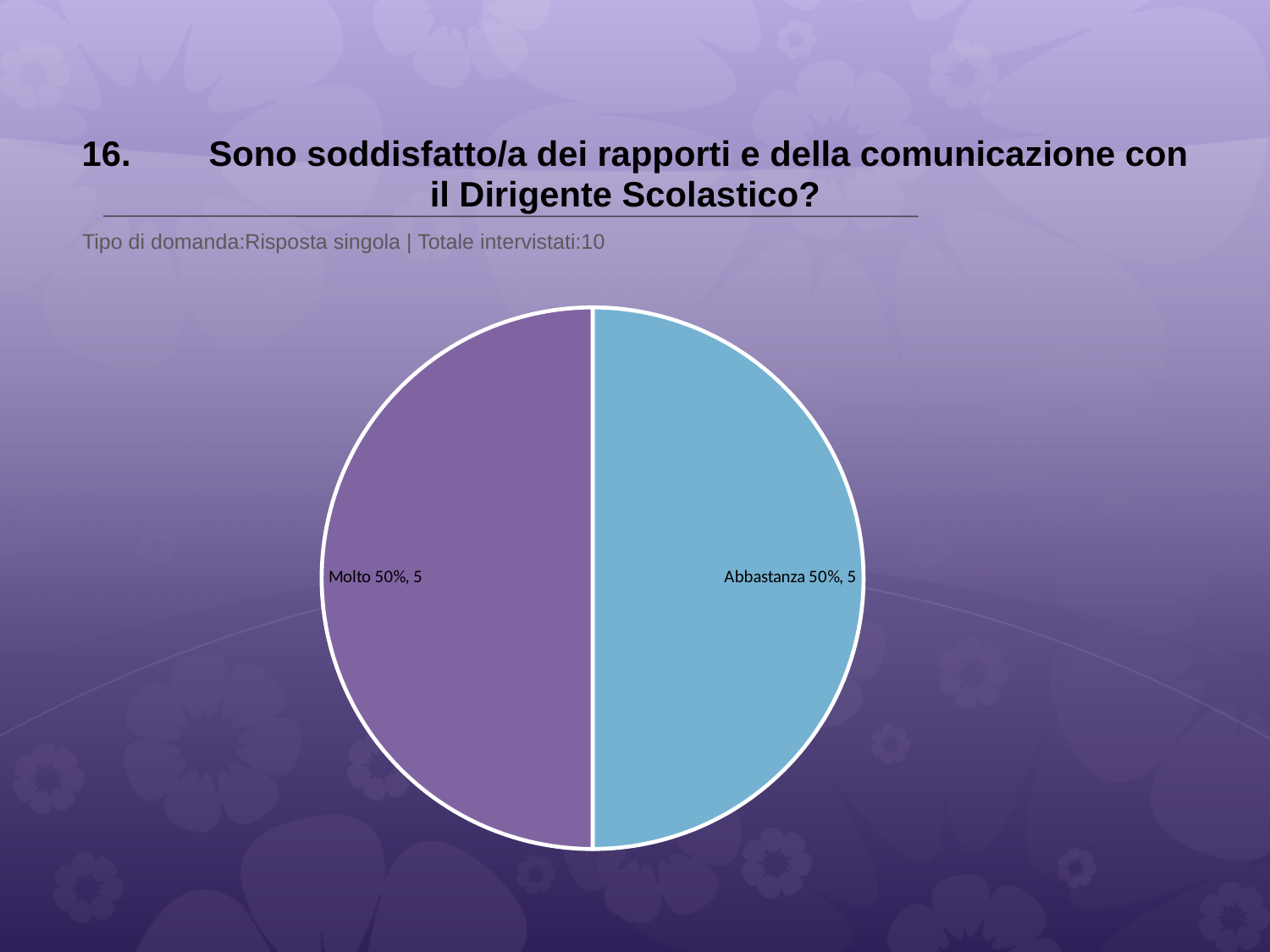
Which slice is shown in purple? Molto What kind of chart is shown on the slide? pie chart How many slices does the pie chart have? 2 What is the count shown for the "Molto" slice? 5 Which slice is shown in blue? Abbastanza What share of the pie does the "Molto" slice represent? 50% What share of the pie does the "Abbastanza" slice represent? 50% What is the total of the counts shown on the two slices? 10 What is the count shown for the "Abbastanza" slice? 5 What is the difference between the counts for "Molto" and "Abbastanza"? 0